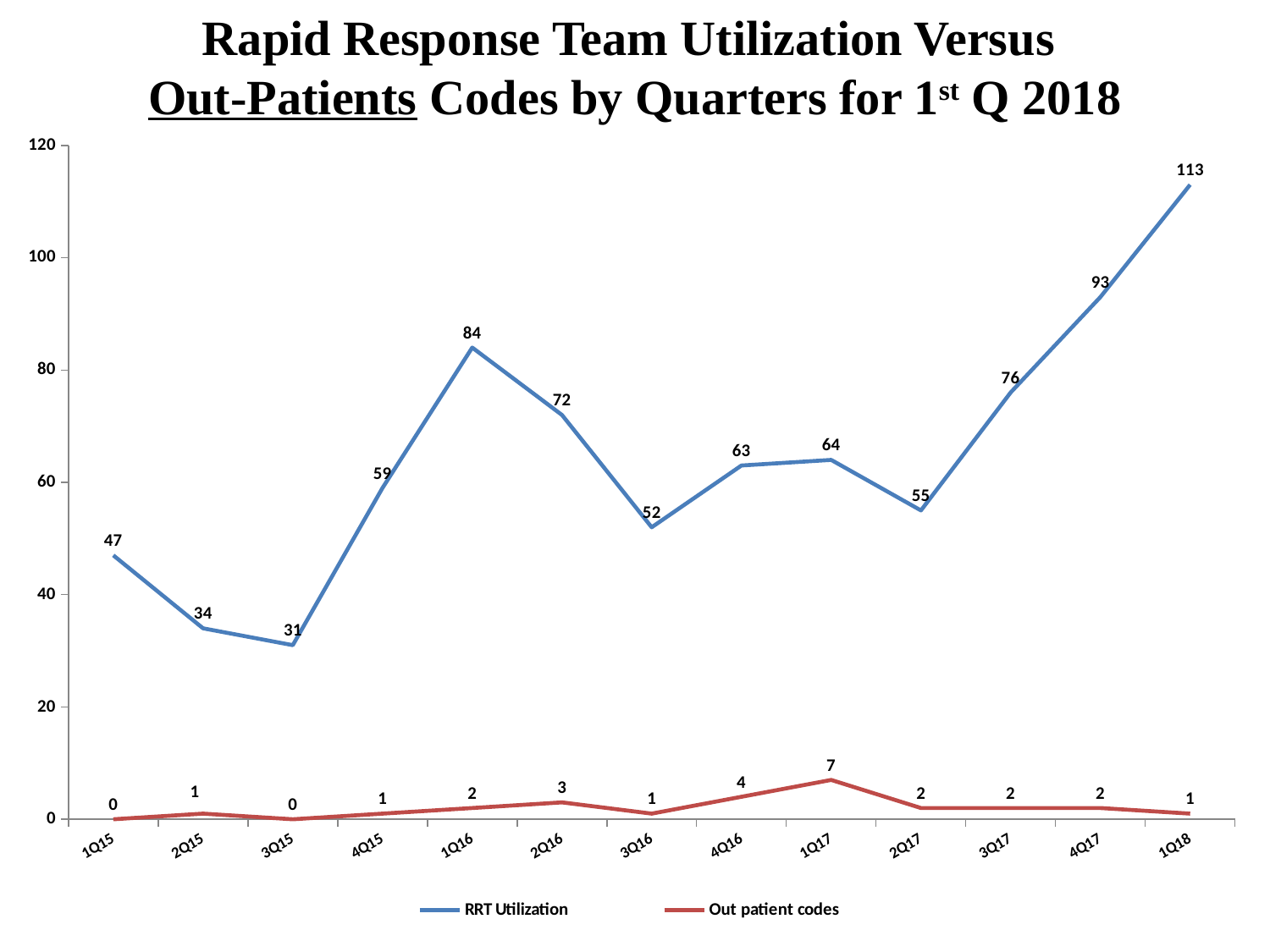
What kind of chart is shown on the slide? Line chart Which quarter has the highest RRT Utilization? 1Q18 What is the RRT Utilization value for 1Q16? 84 Which quarter has the highest Out patient codes value? 1Q17 What is the difference between RRT Utilization in 1Q18 and 4Q17? 20 How many series does the legend list? 2 Which is larger, RRT Utilization in 2Q16 or in 4Q16? 2Q16 Which quarter has the lowest RRT Utilization? 3Q15 How many quarters are plotted on the x axis? 13 Does RRT Utilization rise or fall from 2Q17 to 1Q18? Rise What is the Out patient codes value for 1Q17? 7 What is the RRT Utilization value for 3Q15? 31